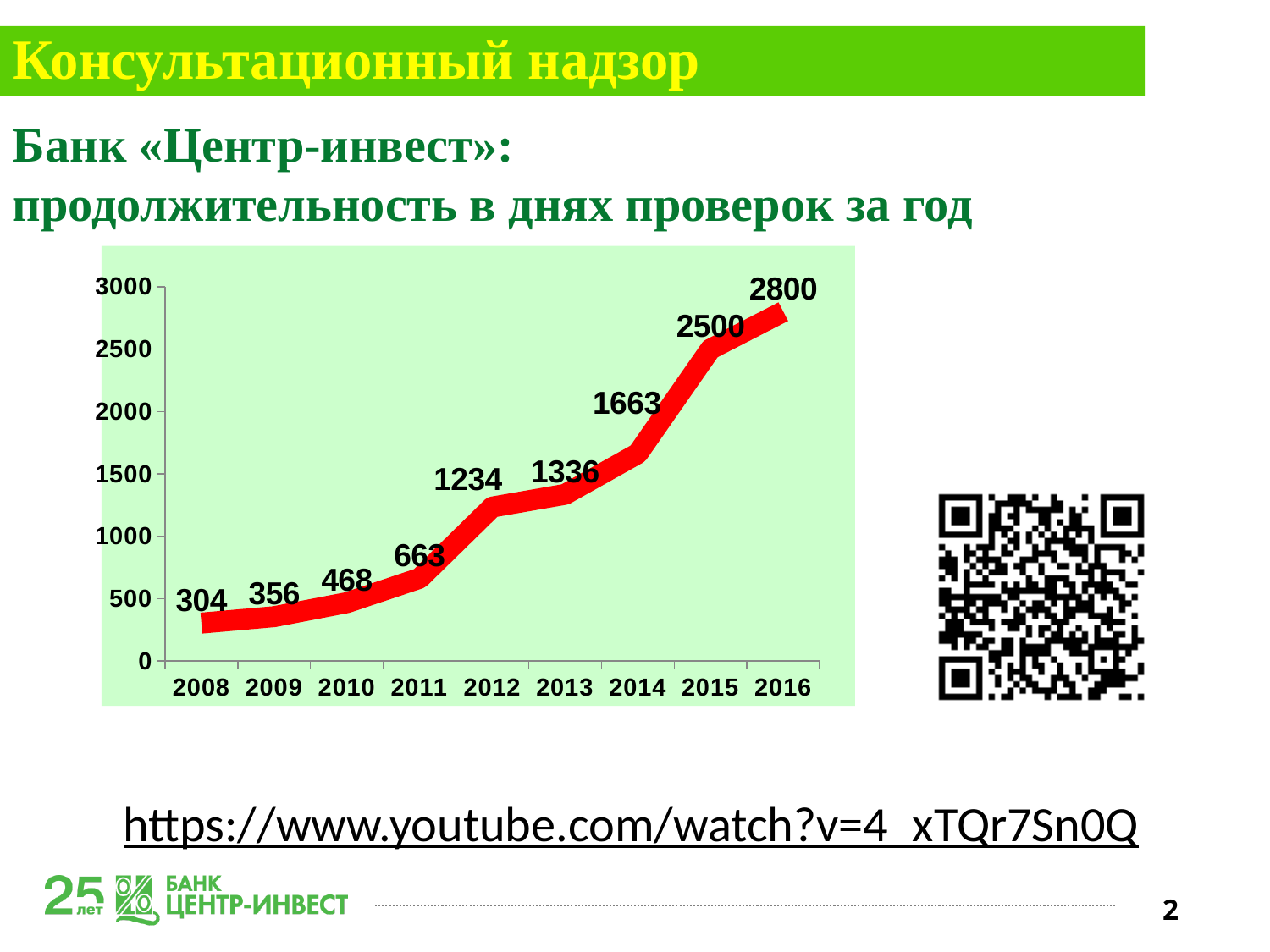
How many years are shown on the x axis? 9 Do the values rise or fall from 2008 to 2016? rise What is the difference between the values for 2014 and 2013? 327 What is the value for 2012? 1234 Is the value for 2014 greater or less than 1500? greater Which is larger, the value for 2011 or the value for 2010? 2011 Which year has the highest value? 2016 What kind of chart is shown on the slide? line chart What is the difference between the values for 2016 and 2015? 300 What is the value for 2008? 304 What is the value for 2015? 2500 Which year has the lowest value? 2008